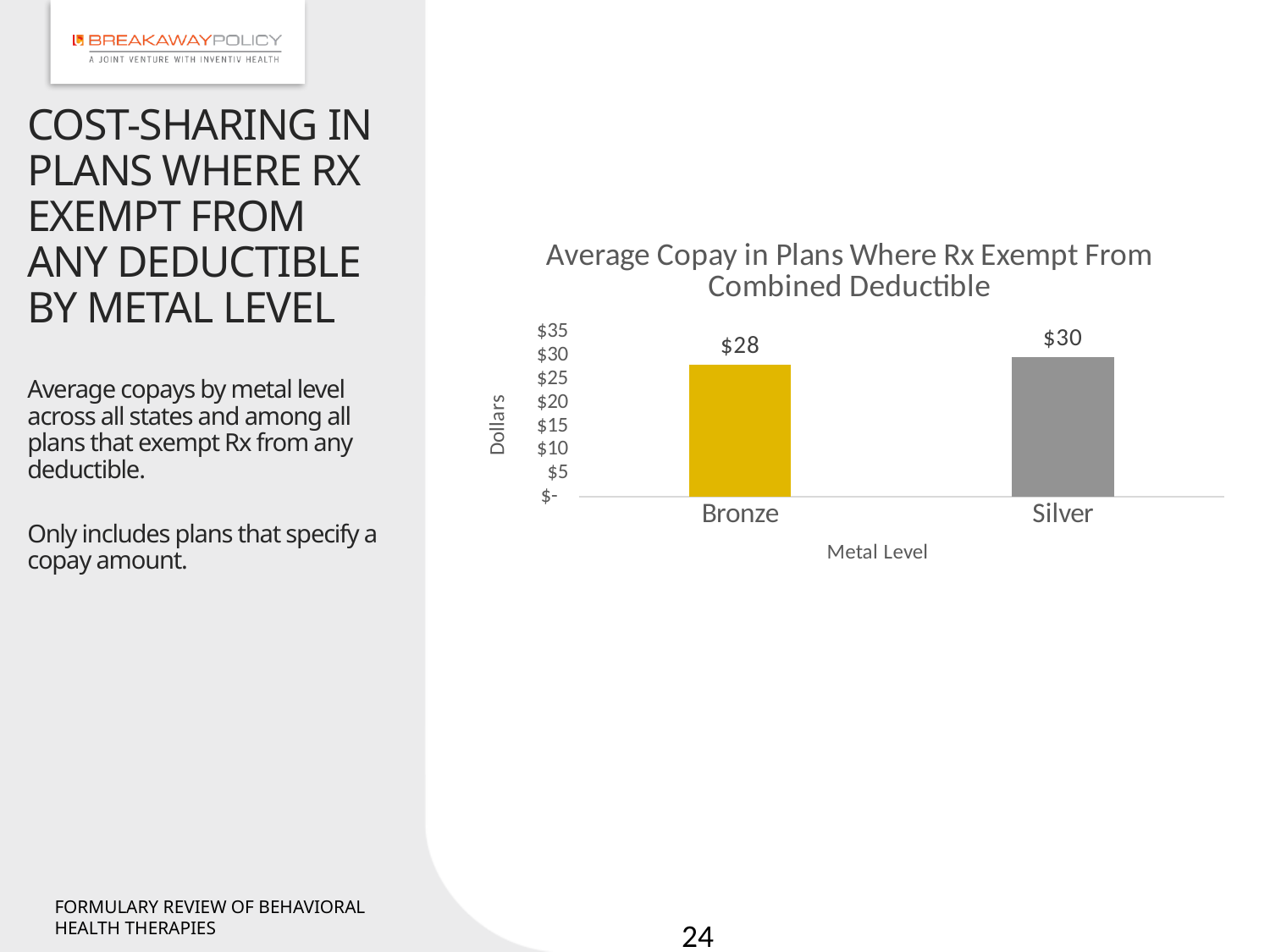
What is the average copay for Bronze plans? $28 Is the average copay for Bronze greater or less than $25? greater What kind of chart is shown on the slide? Bar chart What is the title of the chart? Average Copay in Plans Where Rx Exempt From Combined Deductible How many metal levels are shown in the chart? 2 Which metal level has the higher average copay? Silver Is the average copay for Silver greater or less than $35? less Do the average copay values rise or fall from Bronze to Silver? rise What is the average copay for Silver plans? $30 Which metal level has the lower average copay? Bronze What is the label on the x axis of the chart? Metal Level What is the difference between the Silver and Bronze average copays? $2